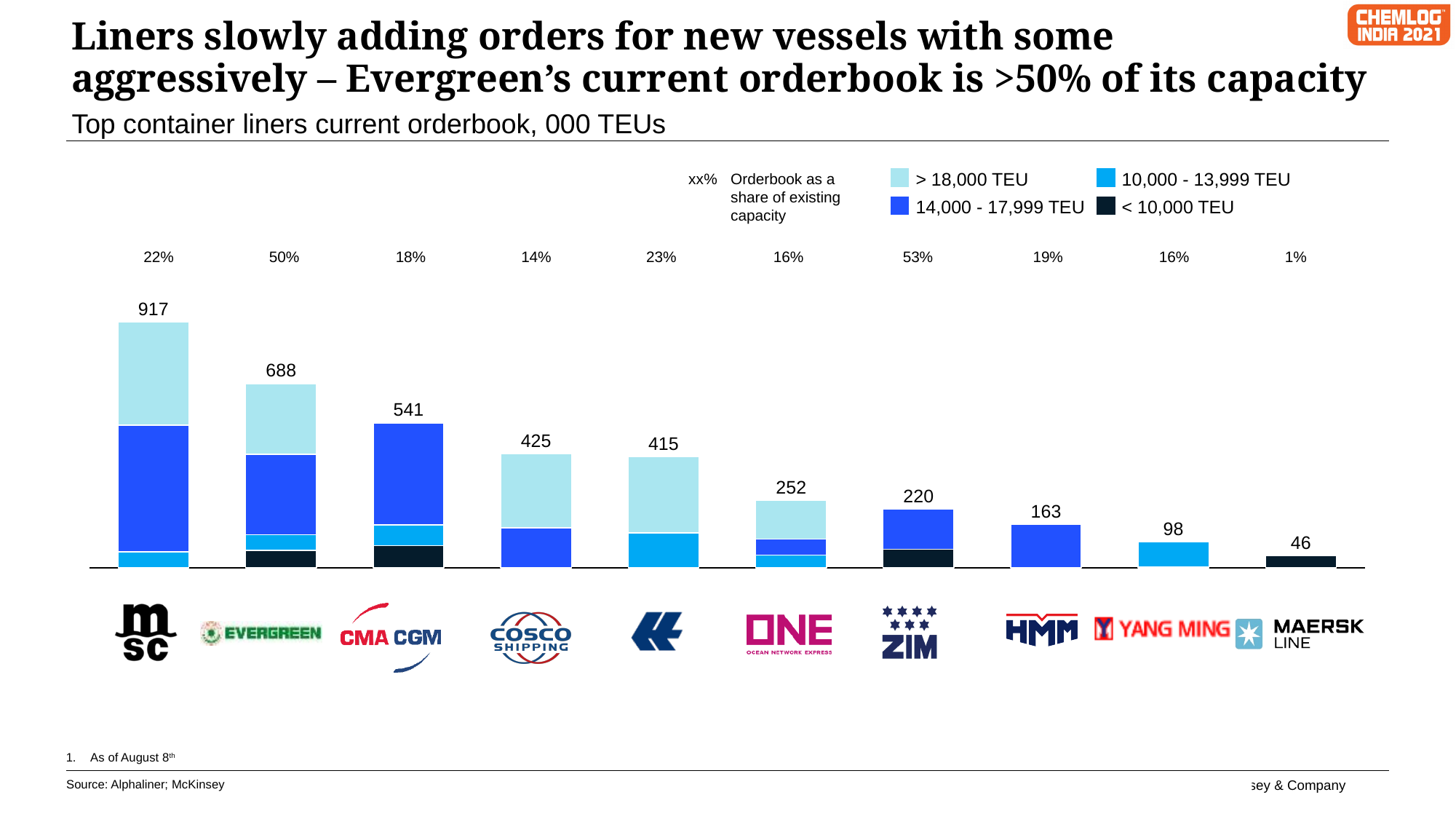
What is the total orderbook value shown for Evergreen? 688 What is the total orderbook value shown for MSC? 917 Which liner has the highest total orderbook value? MSC What is the total orderbook value shown for ZIM? 220 What percentage is shown above the Maersk Line bar for orderbook as a share of existing capacity? 1% Which has a larger total orderbook value, COSCO Shipping or ONE? COSCO Shipping What is the difference between the total orderbook values of MSC and Evergreen? 229 Which liner has the lowest total orderbook value? Maersk Line What kind of chart is shown on the slide? Stacked bar chart How many vessel size categories does the legend list? 4 How many liners are shown as bars in the chart? 10 What percentage is shown above the Evergreen bar for orderbook as a share of existing capacity? 50%